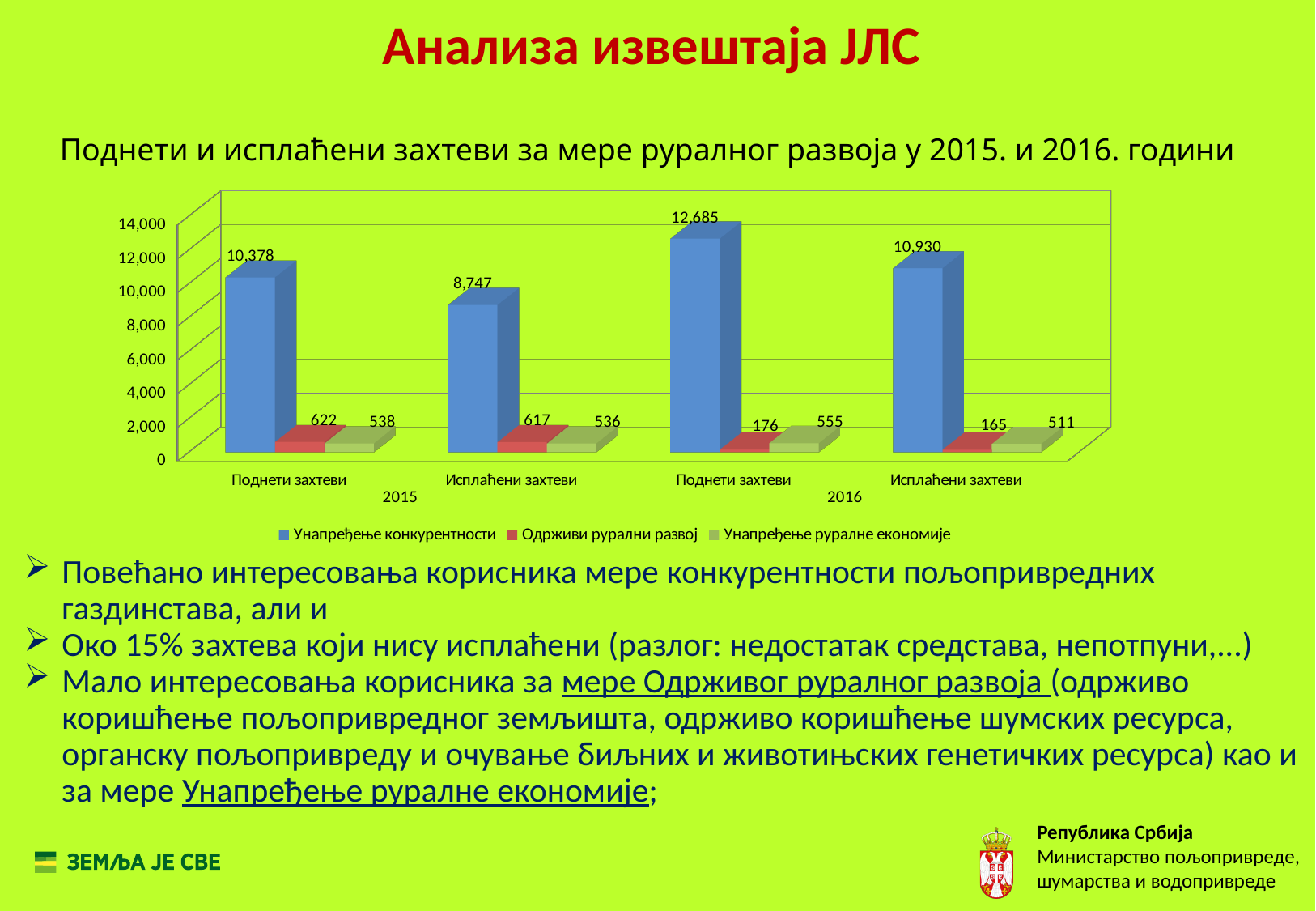
Which colour represents Одрживи рурални развој in the legend? red What is the difference between Поднети захтеви and Исплаћени захтеви for Унапређење конкурентности in 2016? 1,755 What is the value for Унапређење конкурентности for Поднети захтеви in 2015? 10,378 What is the value for Одрживи рурални развој for Исплаћени захтеви in 2016? 165 Which category has the highest value for Унапређење конкурентности? Поднети захтеви 2016 What is the value for Унапређење руралне економије for Поднети захтеви in 2016? 555 What kind of chart is shown on the slide? bar chart How many categories are shown on the x axis? 4 How many series does the legend list? 3 Which category has the lowest value for Одрживи рурални развој? Исплаћени захтеви 2016 Which is larger for Поднети захтеви in 2015: Одрживи рурални развој or Унапређење руралне економије? Одрживи рурални развој Is the value for Унапређење конкурентности for Исплаћени захтеви in 2015 greater or less than 10,000? less